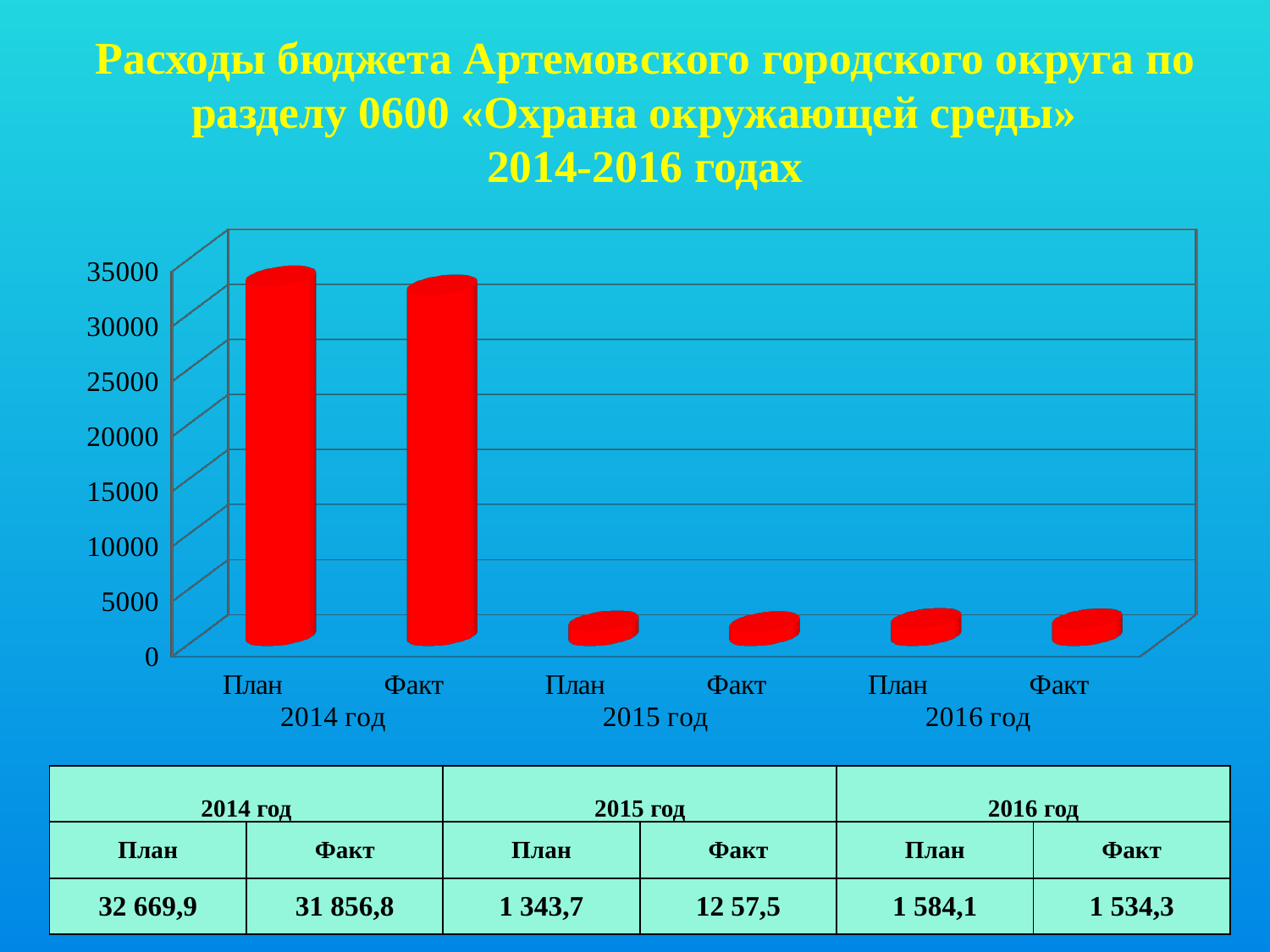
How many bars are plotted in the chart? 6 What colour are the bars in the chart? red Which is larger, План for 2014 год or План for 2015 год? План 2014 год What is the difference between План and Факт for 2014 год? 813,1 What is the value for План in 2016 год? 1 584,1 What is the value for План in 2015 год? 1 343,7 What kind of chart is shown on the slide? bar chart Is the value for Факт in 2014 год greater or less than 30000? greater Which bar is the highest in the chart? План 2014 год What is the value for Факт in 2016 год? 1 534,3 What is the value for Факт in 2014 год? 31 856,8 What is the value for План in 2014 год? 32 669,9